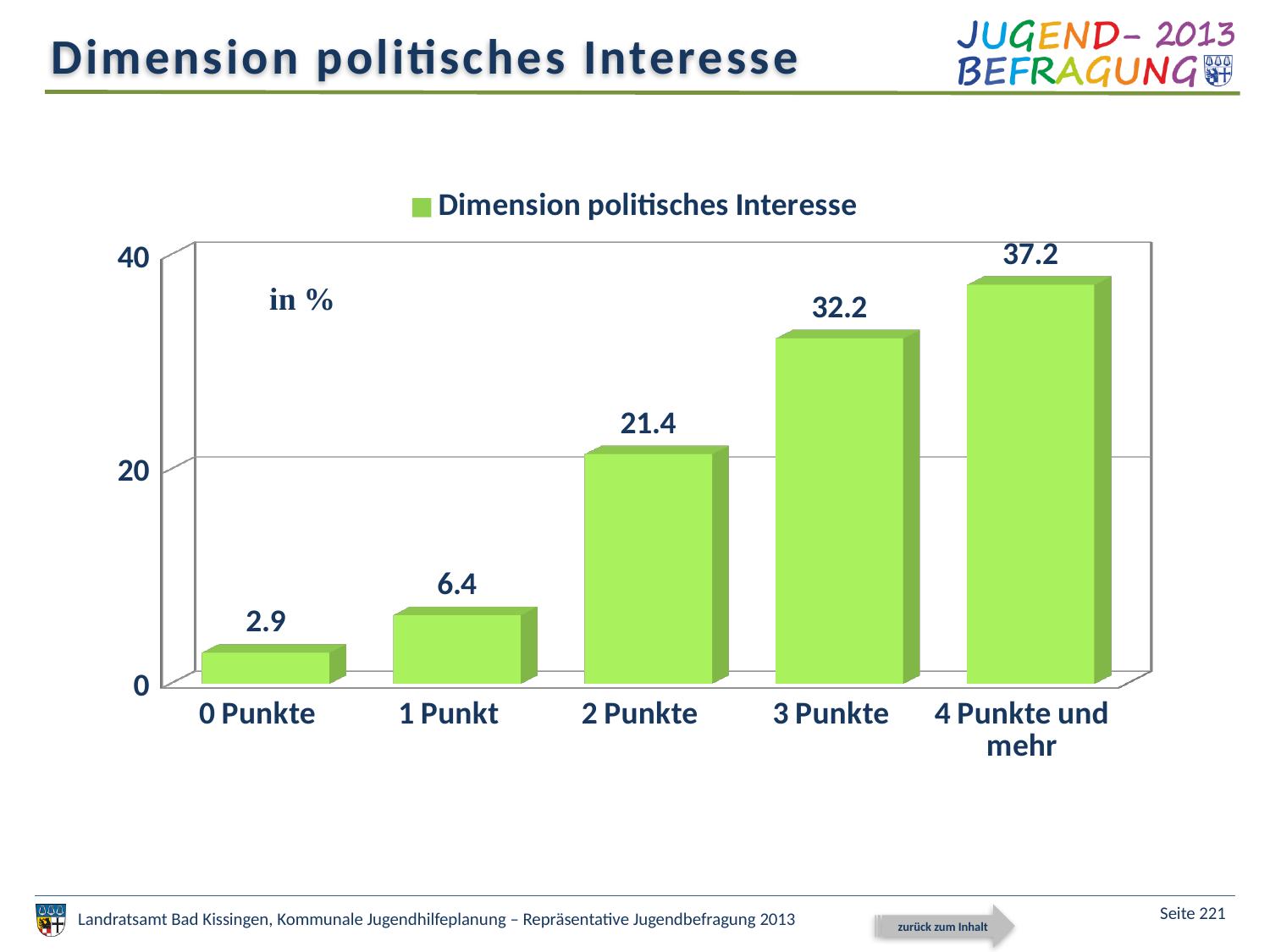
How many categories are shown on the x axis? 5 What is the value for "2 Punkte"? 21.4 Which is larger, the value for "1 Punkt" or the value for "2 Punkte"? 2 Punkte Do the values rise or fall from left to right along the x axis? rise Is the value for "3 Punkte" greater or less than 20? greater What kind of chart is shown on the slide? bar chart How many series does the legend list? 1 Which category has the highest value? 4 Punkte und mehr Which category has the lowest value? 0 Punkte What is the difference between the values for "3 Punkte" and "2 Punkte"? 10.8 What is the value for "4 Punkte und mehr"? 37.2 What is the value for "0 Punkte"? 2.9